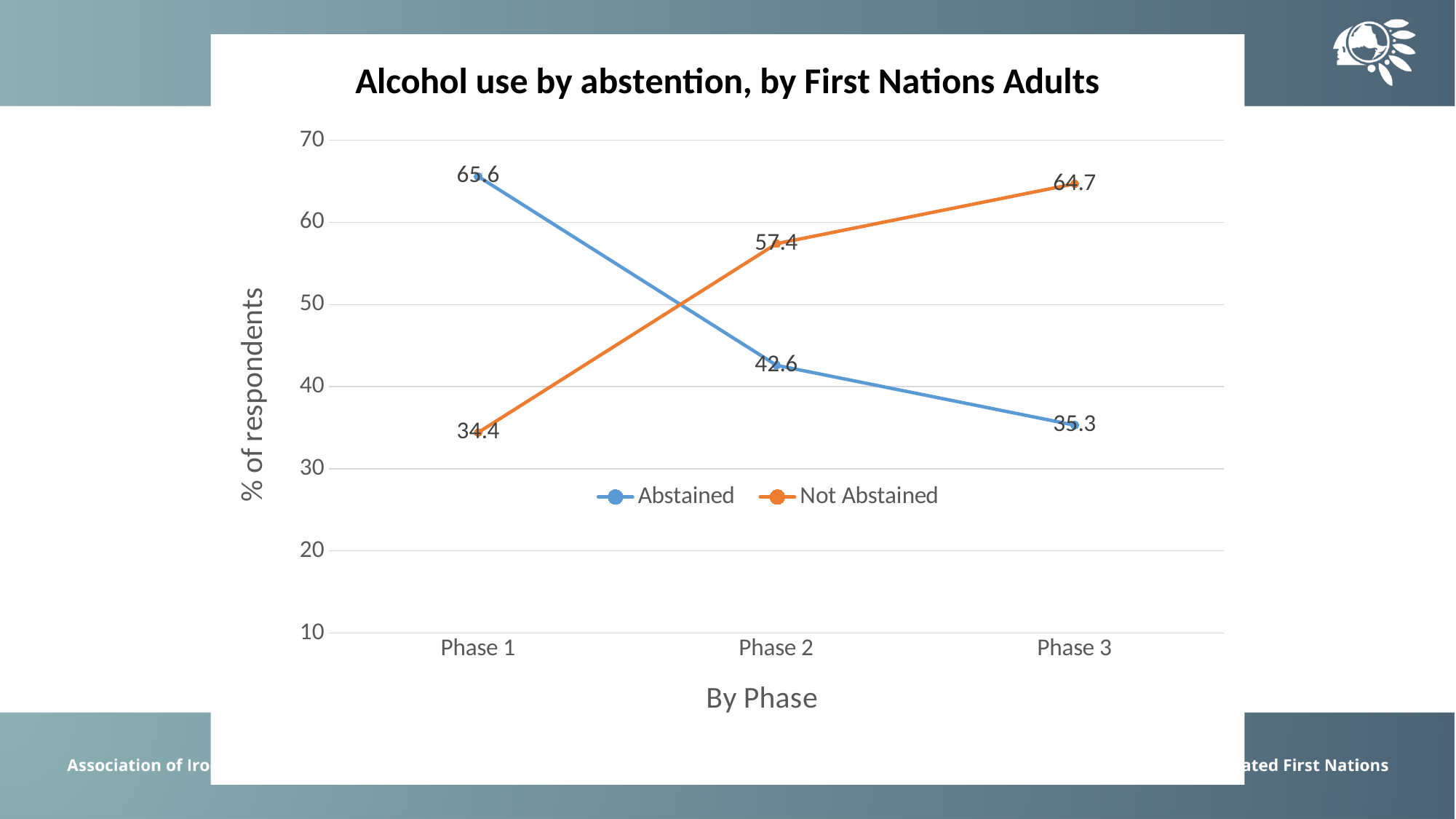
Does the Abstained series rise or fall from Phase 1 to Phase 3? fall Is the Abstained value in Phase 3 greater or less than 40? less In which phase is the Not Abstained value lowest? Phase 1 What kind of chart is shown? line chart In which phase is the Abstained value highest? Phase 1 What is the value for Not Abstained in Phase 3? 64.7 What is the value for Not Abstained in Phase 2? 57.4 What is the value for Abstained in Phase 1? 65.6 How many phases are shown on the x axis? 3 How many series does the legend list? 2 What is the difference between the Abstained and Not Abstained values in Phase 1? 31.2 Which is larger in Phase 2, Abstained or Not Abstained? Not Abstained